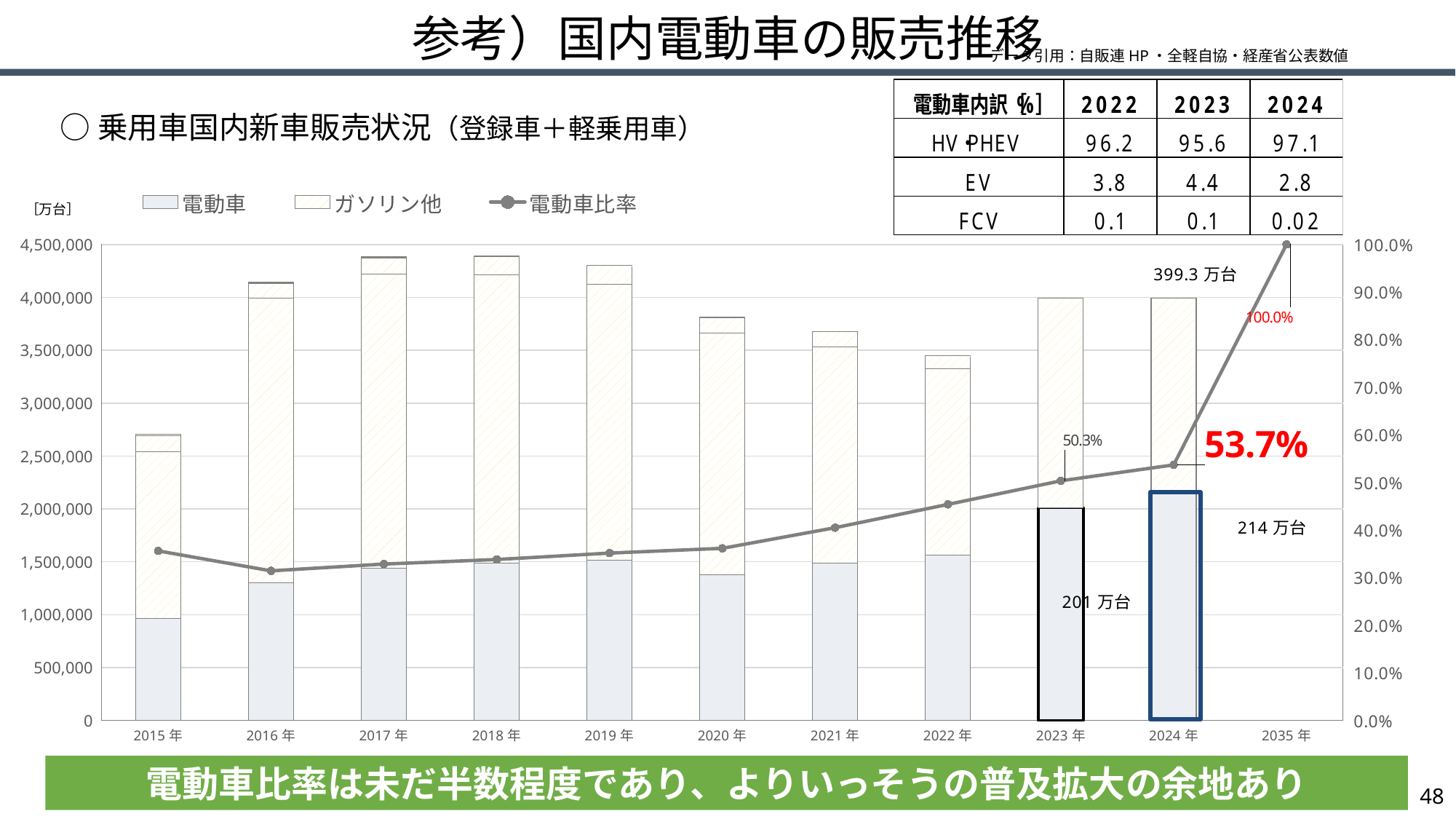
Does the 電動車比率 line rise or fall from 2016年 to 2035年? rise By how many percentage points does the 電動車比率 for 2024年 exceed that for 2023年? 3.4 What is the 電動車比率 value shown for 2035年? 100.0% What is the labelled 電動車 sales volume for 2024年? 214 万台 Which year has the lowest total bar height? 2015年 What is the 電動車比率 value shown for 2024年? 53.7% What is the labelled 電動車 sales volume for 2023年? 201 万台 Is the 電動車比率 for 2016年 greater or less than 40.0%? less How many series does the legend list? 3 Is the total bar for 2017年 greater or less than 4,000,000? greater What is the 電動車比率 value shown for 2023年? 50.3% Which year has the lowest 電動車比率 on the line? 2016年